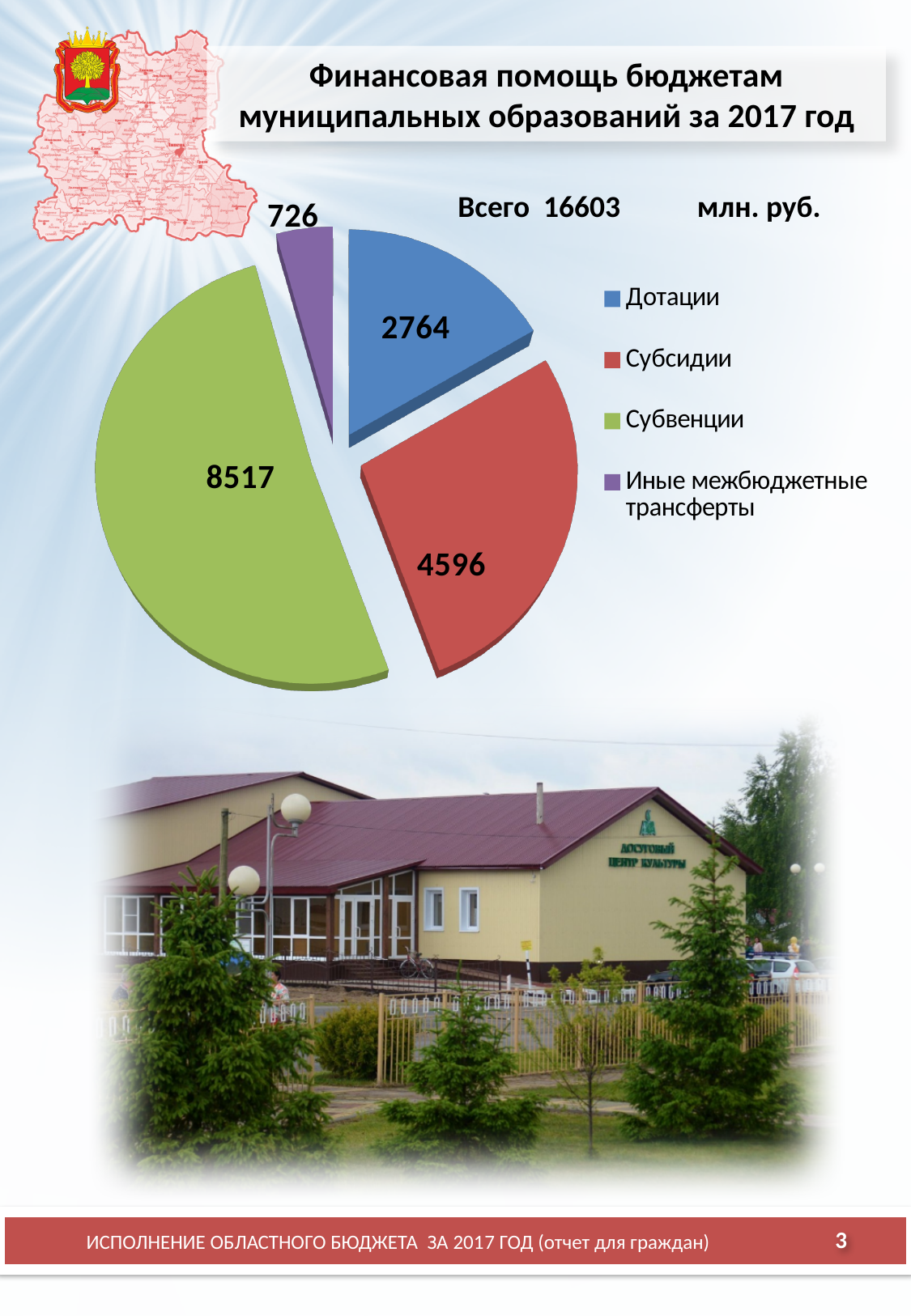
Which category has the largest slice in the pie chart? Субвенции What is the difference between the values for Субсидии and Дотации? 1832 What is the value for Субсидии in the pie chart? 4596 What is the value for Иные межбюджетные трансферты in the pie chart? 726 Which category has the smallest slice in the pie chart? Иные межбюджетные трансферты Which is larger, the value for Дотации or the value for Субсидии? Субсидии What is the value for Дотации in the pie chart? 2764 How many categories does the pie chart show? 4 What total value is stated above the pie chart? 16603 млн. руб. What type of chart is shown on the slide? pie chart What is the value for Субвенции in the pie chart? 8517 What is the difference between the values for Субвенции and Субсидии? 3921